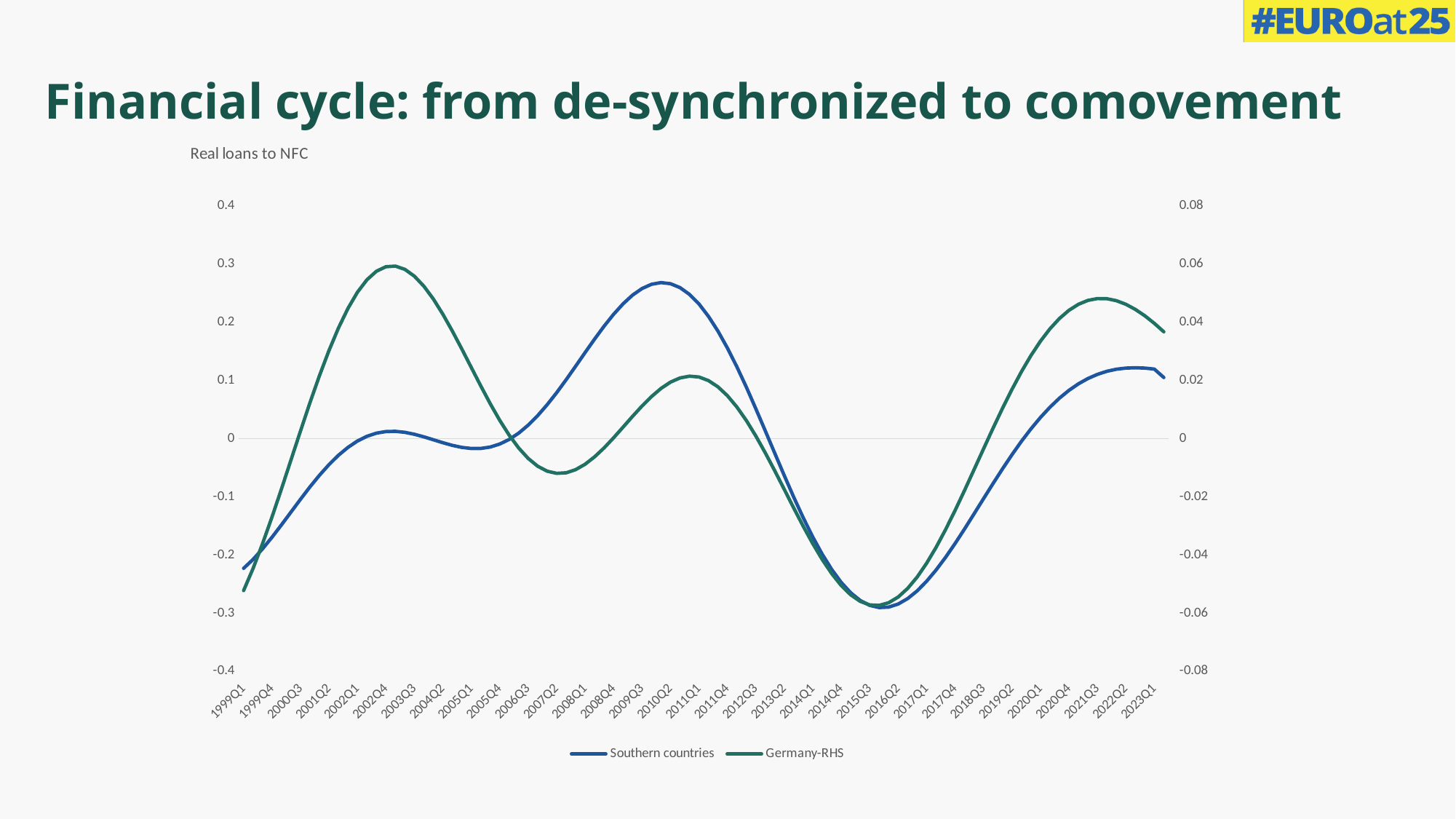
Is the value for Germany-RHS at 2002Q4 greater or less than 0.04 on the right axis? greater How many quarter labels are shown on the x axis? 33 What are the two series named in the chart legend? Southern countries and Germany-RHS Does the Germany-RHS line rise or fall between 2016Q2 and 2021Q3? Rises Does the Southern countries line rise or fall between 2010Q2 and 2016Q2? Falls What kind of chart is shown on the slide? Line chart Is the value for Southern countries at 2010Q2 greater or less than 0.2 on the left axis? greater What is the subtitle printed above the chart? Real loans to NFC Is the value for Southern countries at 1999Q1 greater or less than -0.1 on the left axis? less How many series does the chart legend list? 2